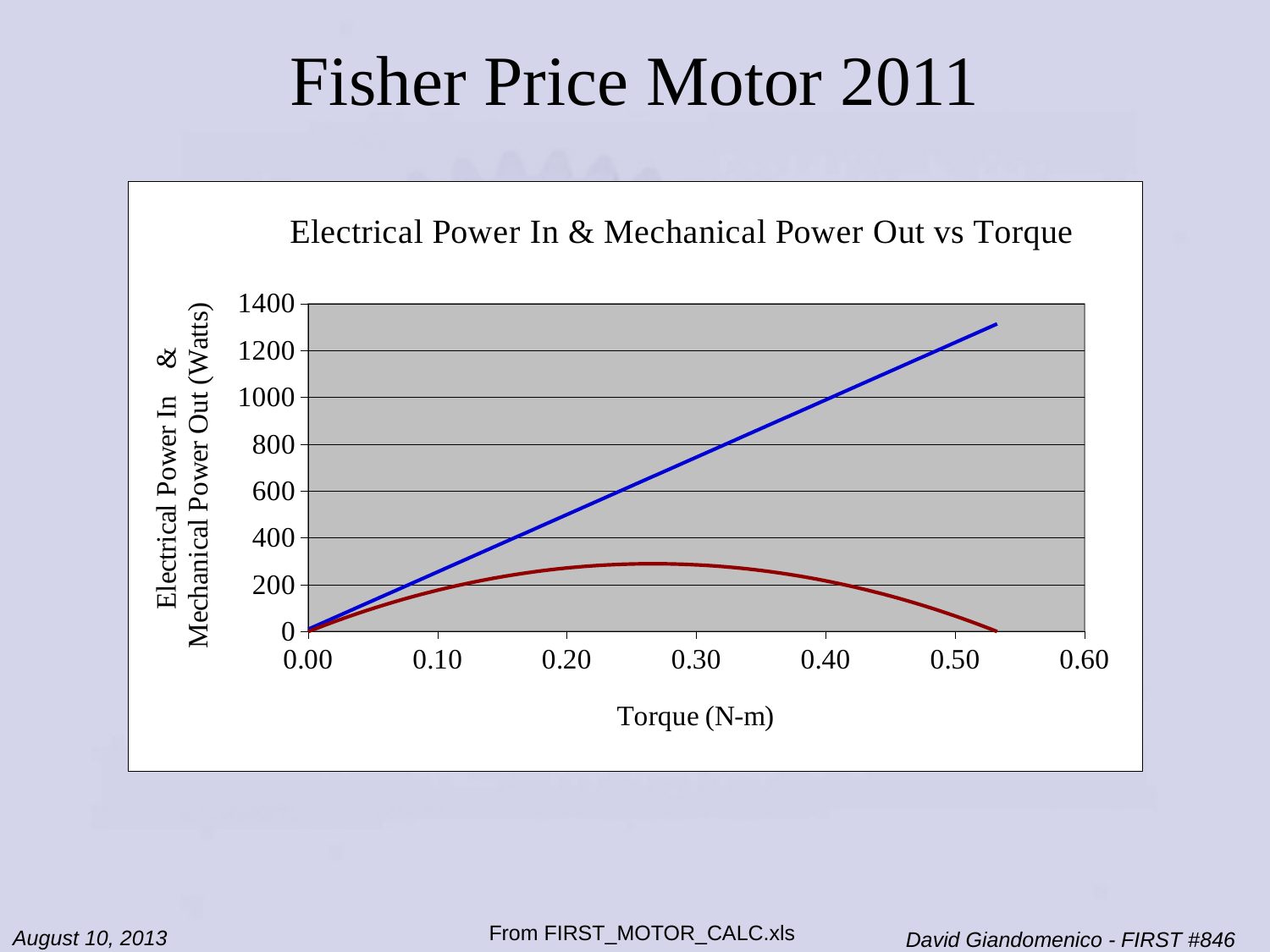
At a torque of 0.50 N-m, is the value of the dark red curve greater or less than 200? less What is the label of the x axis? Torque (N-m) How many lines are plotted on the chart? 2 Does the blue line rise or fall as torque increases? rises What is the title of the chart? Electrical Power In & Mechanical Power Out vs Torque Is the peak value of the dark red curve greater or less than 200? greater Does the dark red curve rise or fall as torque increases from 0.30 to 0.50 N-m? falls Is the peak value of the dark red curve greater or less than 400? less At a torque of 0.40 N-m, which line has the higher value, the blue line or the dark red curve? the blue line What kind of chart is shown on the slide? line chart